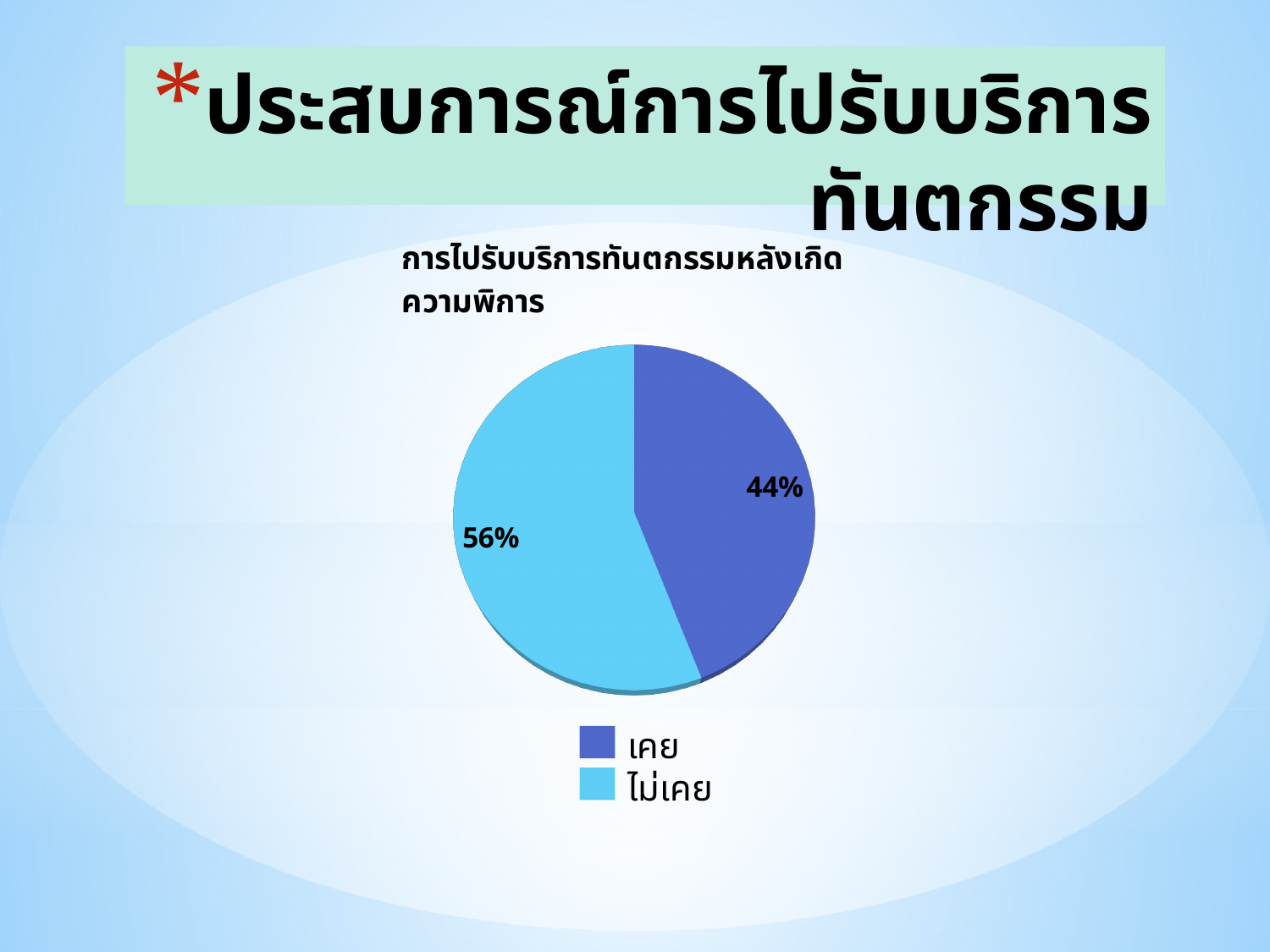
What is the value for ไม่เคย? 56% How many slices does the pie chart have? 2 What is the value for เคย? 44% Which category has the smallest share of the pie? เคย What kind of chart is shown on the slide? pie chart What share of the pie does เคย represent? 44% Which category has the largest share of the pie? ไม่เคย How many entries does the legend list? 2 Which is larger, the share for เคย or the share for ไม่เคย? ไม่เคย Which colour represents ไม่เคย in the pie chart? light blue What is the title of the chart? การไปรับบริการทันตกรรมหลังเกิดความพิการ What is the difference between the shares for ไม่เคย and เคย? 12%